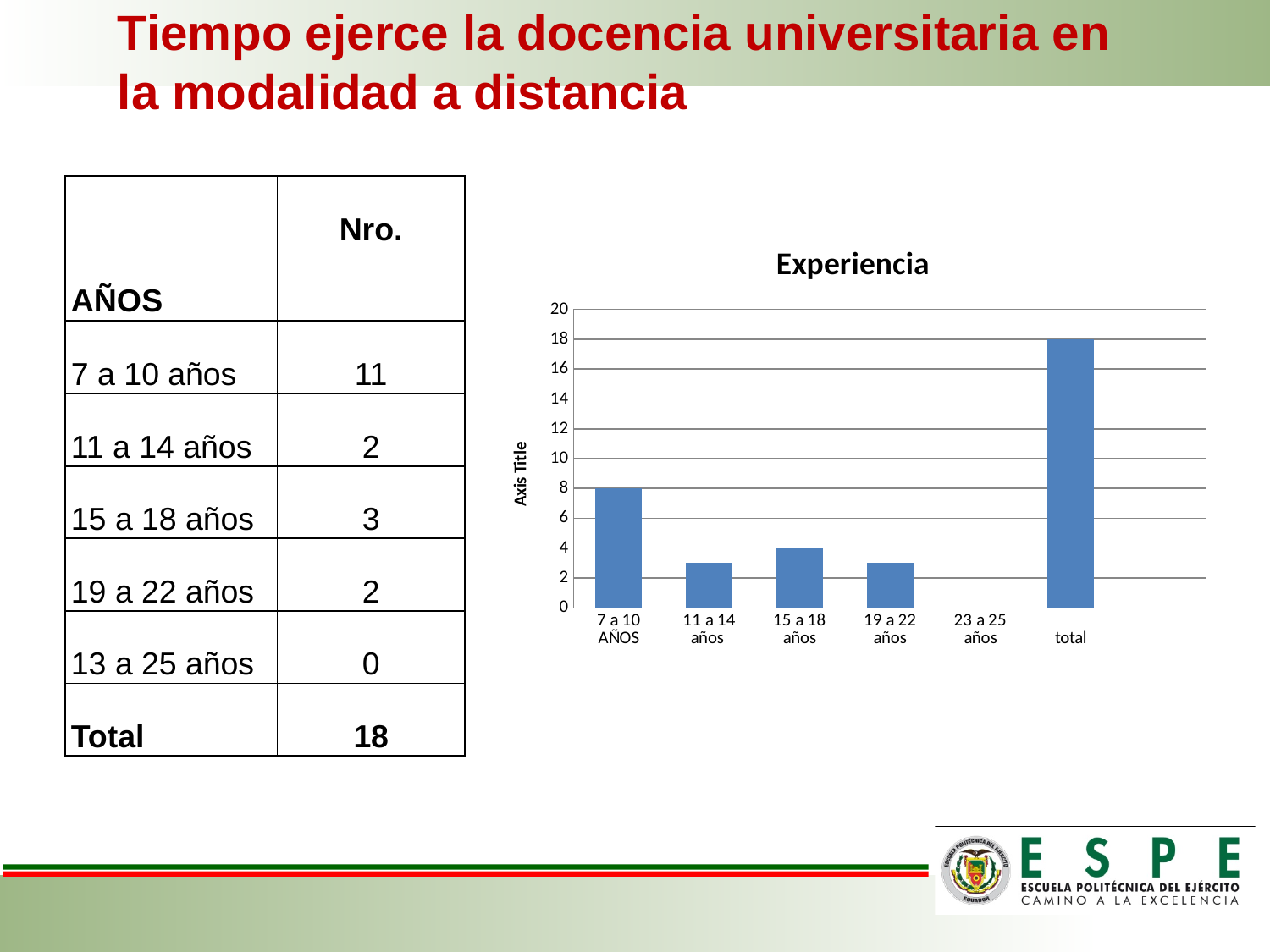
Which is larger, the bar for 7 a 10 AÑOS or the bar for 15 a 18 años? 7 a 10 AÑOS What is the value of the bar for 15 a 18 años? 4 Is the value for 11 a 14 años greater or less than 4? less Which category has the highest bar in the chart? total Which category has the lowest bar in the chart? 23 a 25 años What is the value of the bar for 7 a 10 AÑOS? 8 What is the title of the chart? Experiencia What is the value of the bar for total? 18 What is the difference between the bar for total and the bar for 7 a 10 AÑOS? 10 What kind of chart is shown on the slide? bar chart How many categories are shown on the x axis of the chart? 6 Is the value for 19 a 22 años greater or less than 2? greater